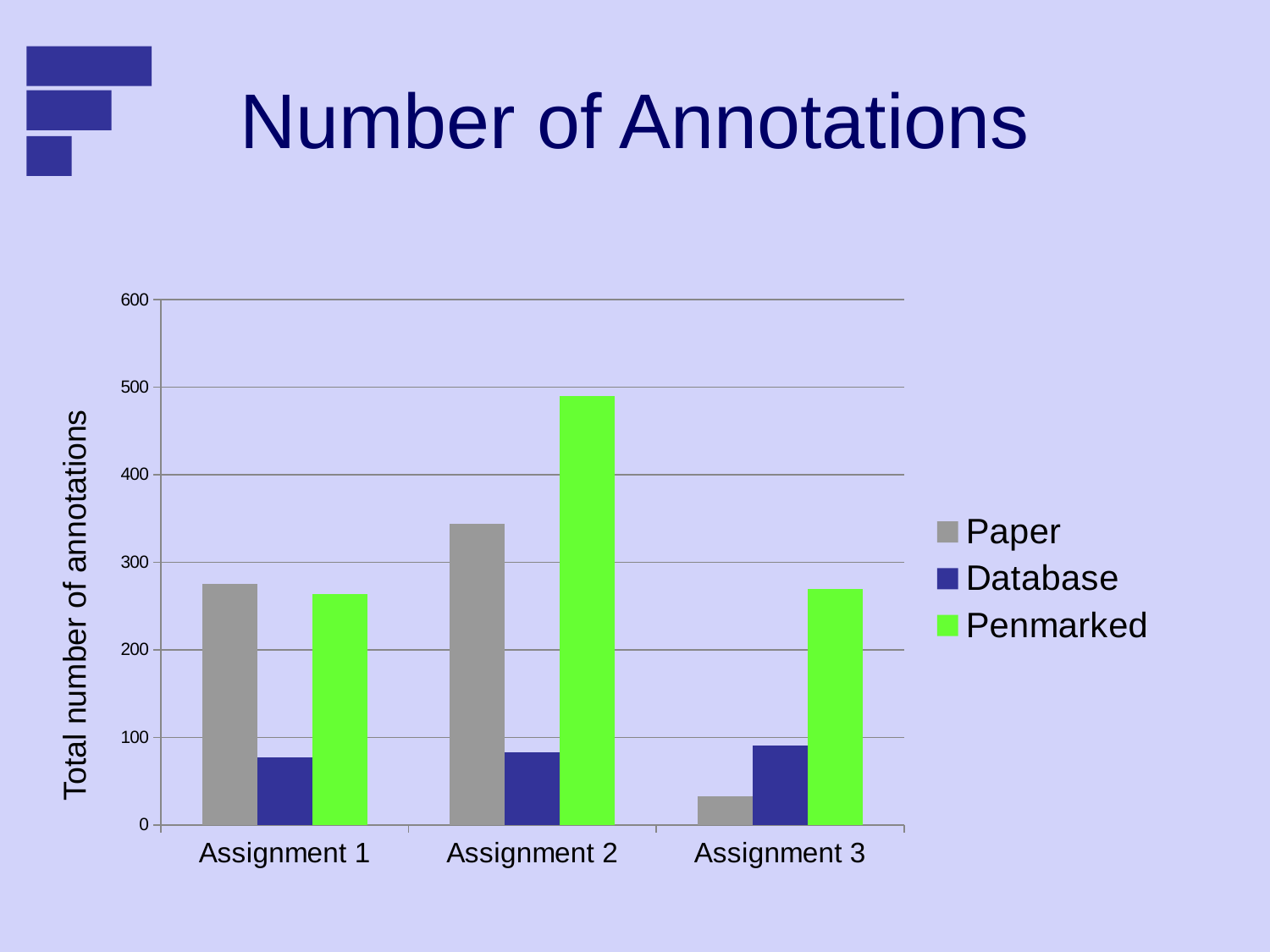
For Assignment 2, which is larger, the Paper value or the Database value? Paper Is the Penmarked value for Assignment 2 greater or less than 400? greater Is the Database value for Assignment 1 greater or less than 100? less How many series does the legend list? 3 How many assignments are shown on the x axis? 3 For Assignment 3, which is larger, the Paper value or the Penmarked value? Penmarked Which assignment has the highest Penmarked value? Assignment 2 Which assignment has the lowest Paper value? Assignment 3 What is the label on the vertical axis? Total number of annotations Is the Paper value for Assignment 3 greater or less than 100? less Which assignment has the highest Paper value? Assignment 2 What kind of chart is shown on the slide? bar chart